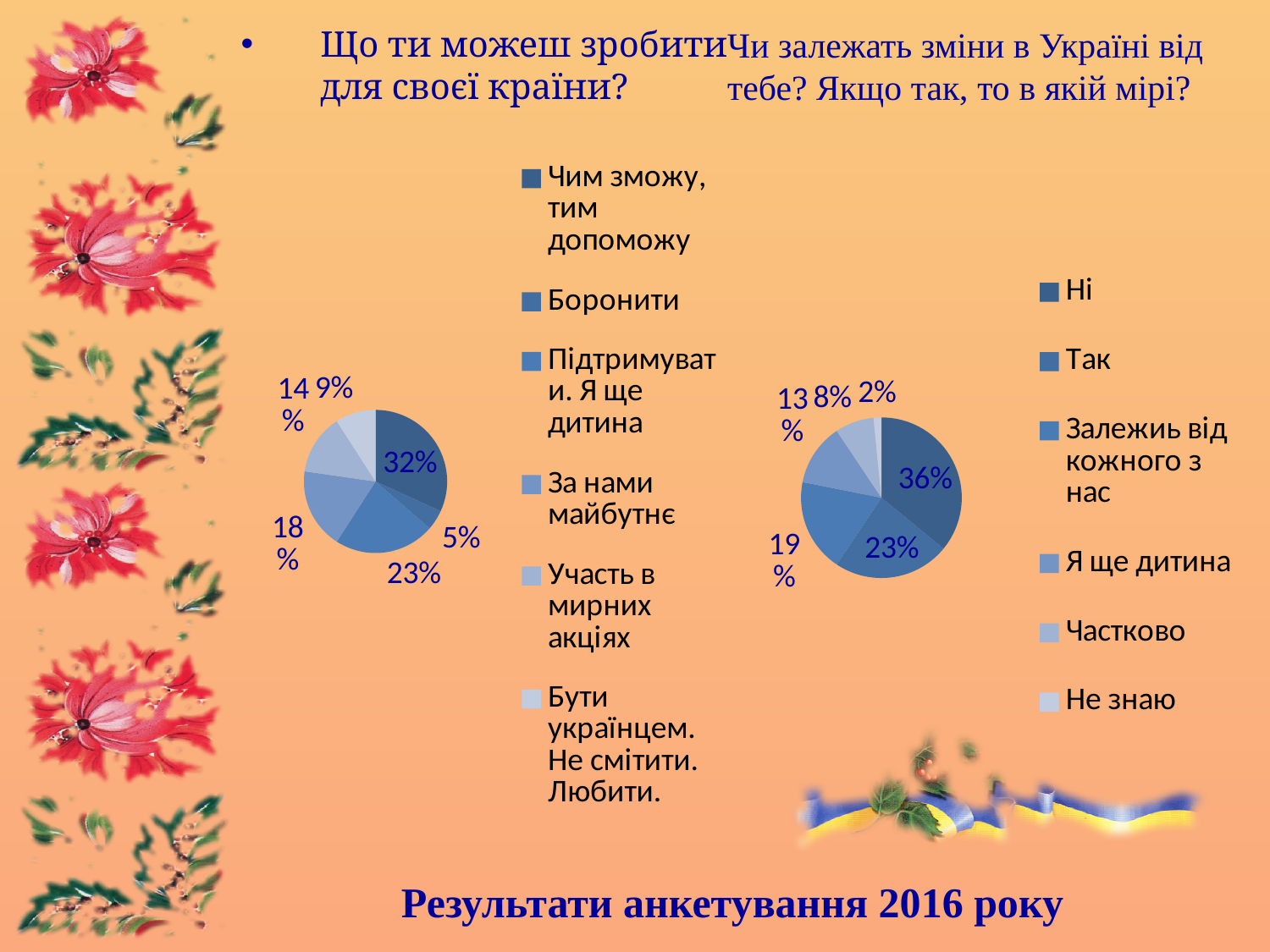
In the right pie chart ("Чи залежать зміни в Україні від тебе?"), what share is labelled for "Ні"? 36% In the left pie chart ("Що ти можеш зробити для своєї країни?"), what share is labelled for "Чим зможу, тим допоможу"? 32% In the left pie chart ("Що ти можеш зробити для своєї країни?"), what share is labelled for "Боронити"? 5% How many categories does the legend of the left pie chart ("Що ти можеш зробити для своєї країни?") list? 6 How many categories does the legend of the right pie chart ("Чи залежать зміни в Україні від тебе?") list? 6 In the right pie chart ("Чи залежать зміни в Україні від тебе?"), which category has the smallest slice? Не знаю In the right pie chart ("Чи залежать зміни в Україні від тебе?"), which is larger: the slice for "Ні" or the slice for "Так"? Ні In the left pie chart ("Що ти можеш зробити для своєї країни?"), which category has the largest slice? Чим зможу, тим допоможу In the right pie chart ("Чи залежать зміни в Україні від тебе?"), what share is labelled for "Так"? 23% In the left pie chart ("Що ти можеш зробити для своєї країни?"), which category has the smallest slice? Боронити In the left pie chart ("Що ти можеш зробити для своєї країни?"), what is the difference between the 32% slice and the 23% slice? 9% What kind of chart is used for the question "Що ти можеш зробити для своєї країни?"? pie chart